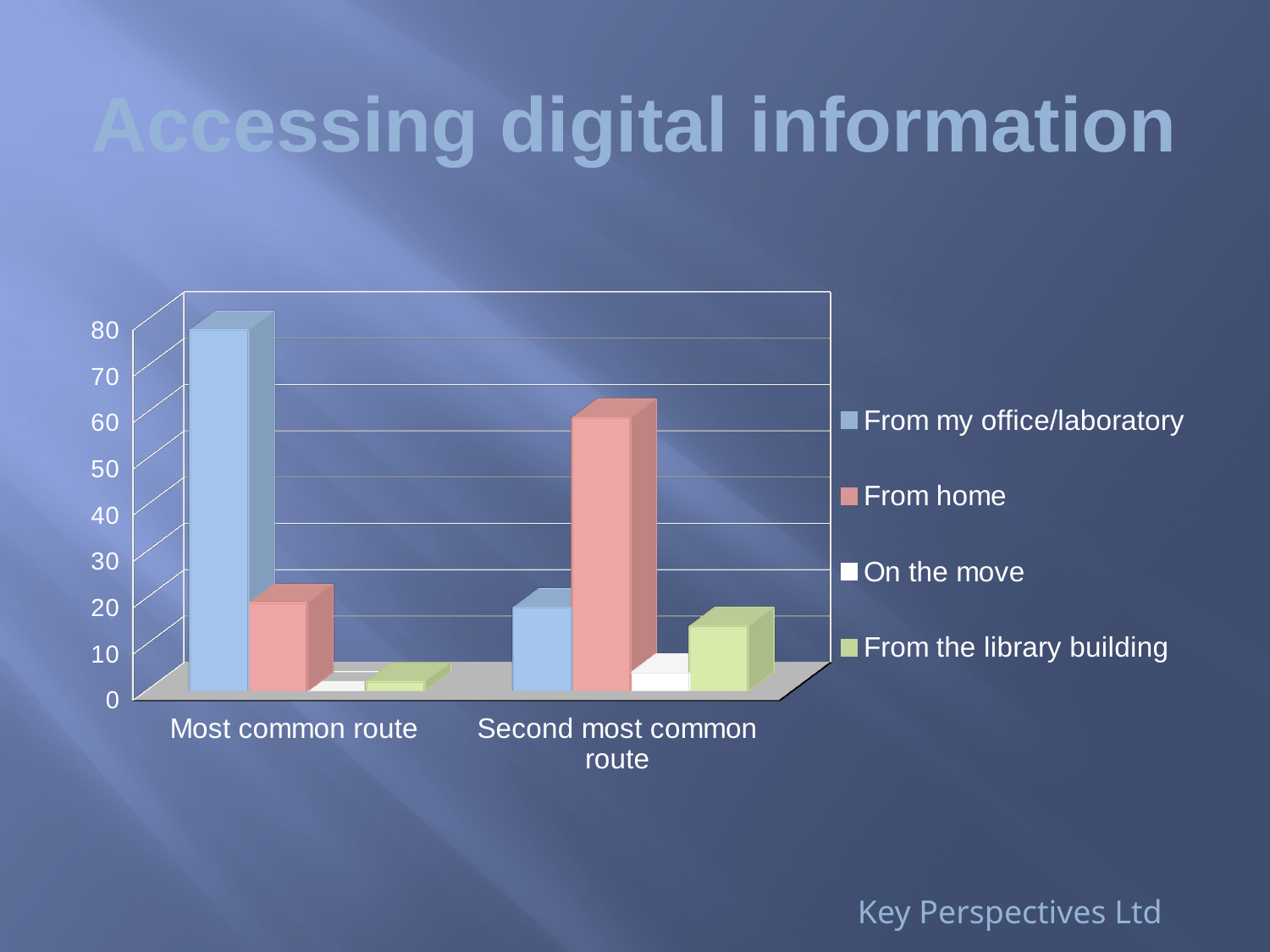
What is the title of the slide containing the chart? Accessing digital information Is the value for 'From my office/laboratory' in 'Most common route' greater or less than 70? greater Which is larger: 'From my office/laboratory' in 'Most common route' or 'From home' in 'Second most common route'? From my office/laboratory in Most common route Is the value for 'From my office/laboratory' in 'Second most common route' greater or less than 30? less Which is larger: 'From the library building' in 'Most common route' or 'From the library building' in 'Second most common route'? Second most common route Which series has the highest value for 'Second most common route'? From home Is the value for 'From home' in 'Second most common route' greater or less than 50? greater How many series does the legend list? 4 How many categories are shown on the x axis? 2 What kind of chart is shown on the slide? bar chart Which series has the highest value for 'Most common route'? From my office/laboratory